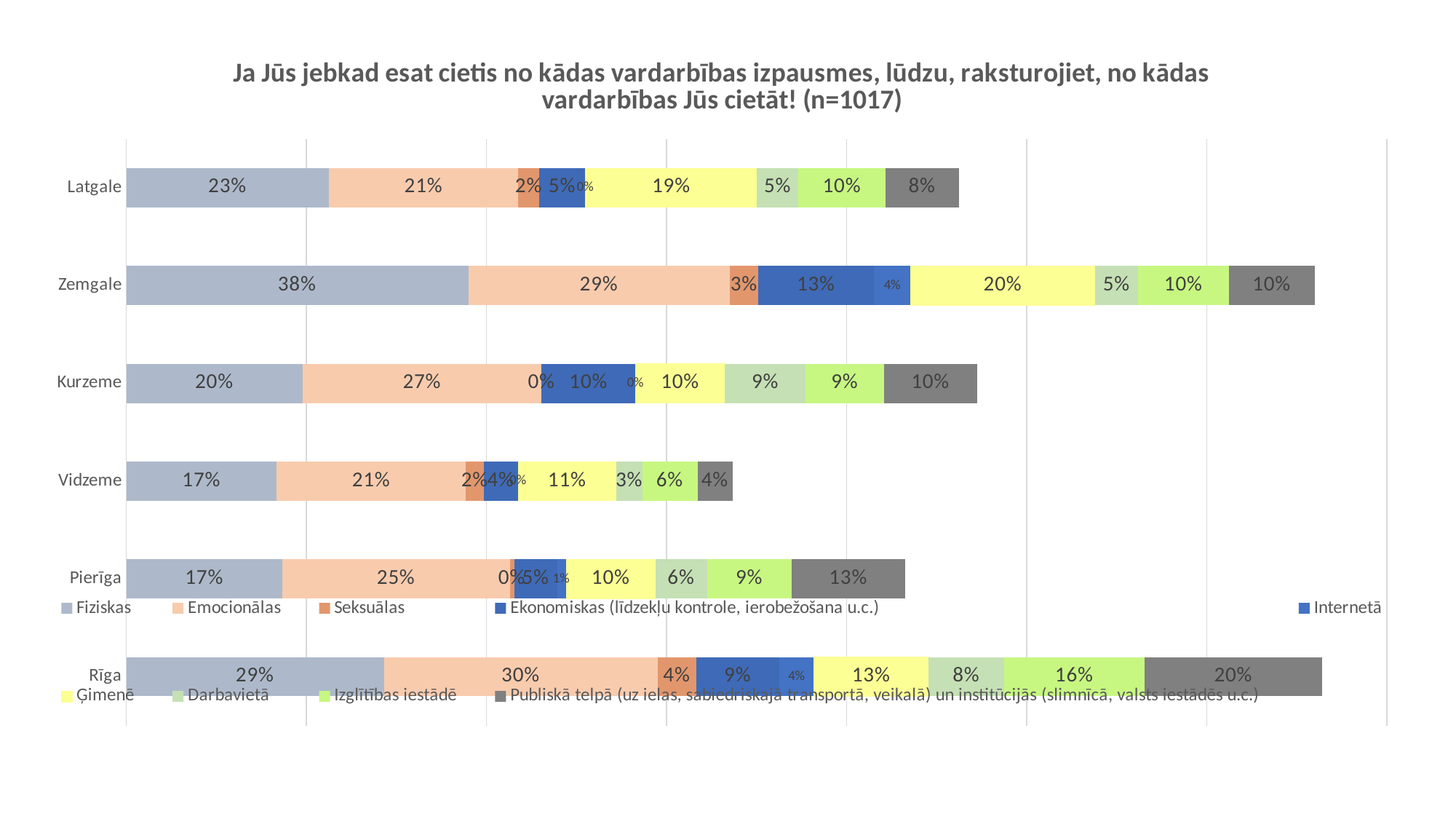
What is the difference between the Emocionālas values for Zemgale and Vidzeme? 8% Which region has the lowest value for Publiskā telpā un institūcijās? Vidzeme What kind of chart is shown on the slide? Stacked bar chart How many regions are shown on the chart? 6 What is the value for Publiskā telpā (uz ielas, sabiedriskajā transportā, veikalā) un institūcijās in Pierīga? 13% Which region has the highest value for Fiziskas? Zemgale What is the total of the stacked bar for Vidzeme? 68% What is the value for Emocionālas in Rīga? 30% How many series does the legend list? 9 Which is larger, the Ekonomiskas value for Zemgale or for Kurzeme? Zemgale What is the value for Ģimenē in Latgale? 19% What is the value for Fiziskas in Zemgale? 38%